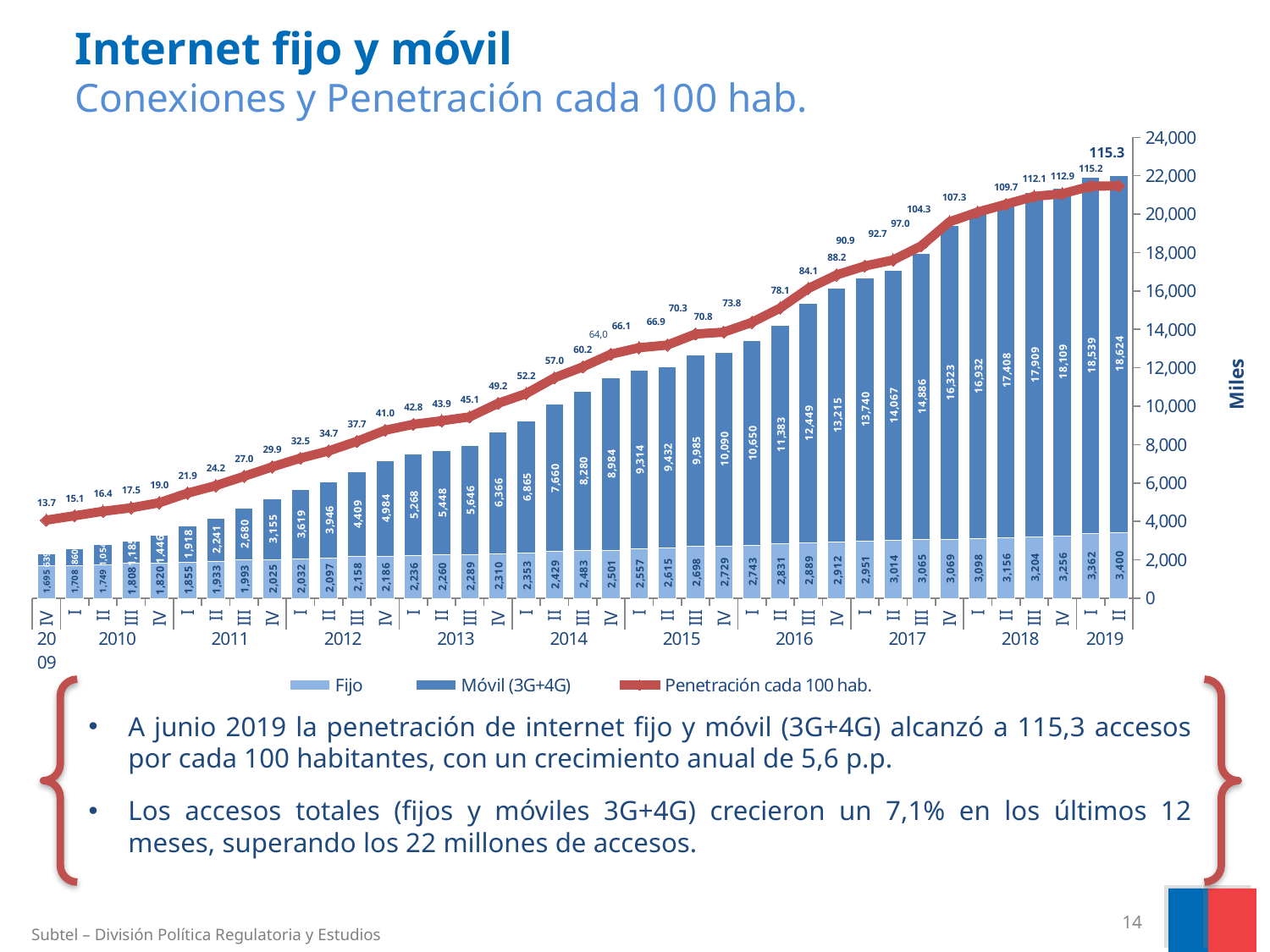
How many series does the legend list? 3 What is the value of Móvil (3G+4G) for II 2019? 18,624 What is the value of Móvil (3G+4G) for IV 2017? 16,323 What is the Penetración cada 100 hab. value for IV 2009? 13.7 Does the Penetración cada 100 hab. line rise or fall from IV 2009 to II 2019? Rises What is the difference between the Móvil (3G+4G) values for II 2019 and I 2019? 85 What is the Penetración cada 100 hab. value for II 2019? 115.3 Which is larger in IV 2014, the Móvil (3G+4G) value or the Fijo value? Móvil (3G+4G) What is the value of Fijo for II 2019? 3,400 What is the total of the stacked bar (Fijo plus Móvil) for II 2019? 22,024 What kind of chart is shown on the slide? Stacked bar chart with a line In which quarter is the Penetración cada 100 hab. value highest? II 2019